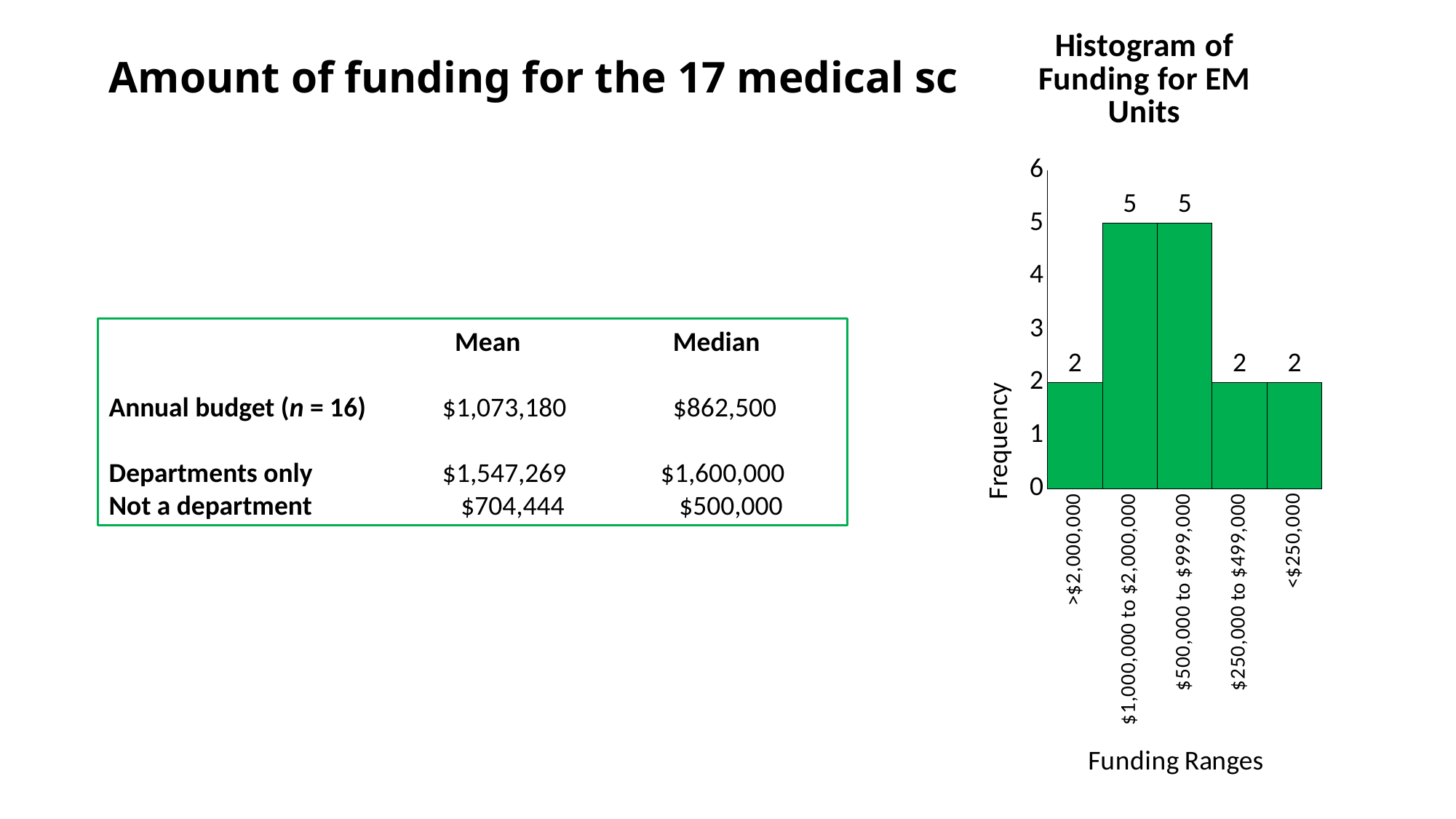
What is the frequency for the $1,000,000 to $2,000,000 funding range? 5 Is the frequency for the $1,000,000 to $2,000,000 range greater or less than 4? greater What is the frequency for the >$2,000,000 funding range? 2 What kind of chart is shown on the slide? bar chart (histogram) What is the frequency for the $500,000 to $999,000 funding range? 5 Which has the higher frequency, the $500,000 to $999,000 range or the <$250,000 range? $500,000 to $999,000 What is the label of the y axis of the histogram? Frequency What is the total frequency across all five funding ranges in the histogram? 16 What is the difference in frequency between the $1,000,000 to $2,000,000 range and the $250,000 to $499,000 range? 3 What is the frequency for the <$250,000 funding range? 2 How many funding ranges are shown on the x axis of the histogram? 5 What is the title of the chart? Histogram of Funding for EM Units